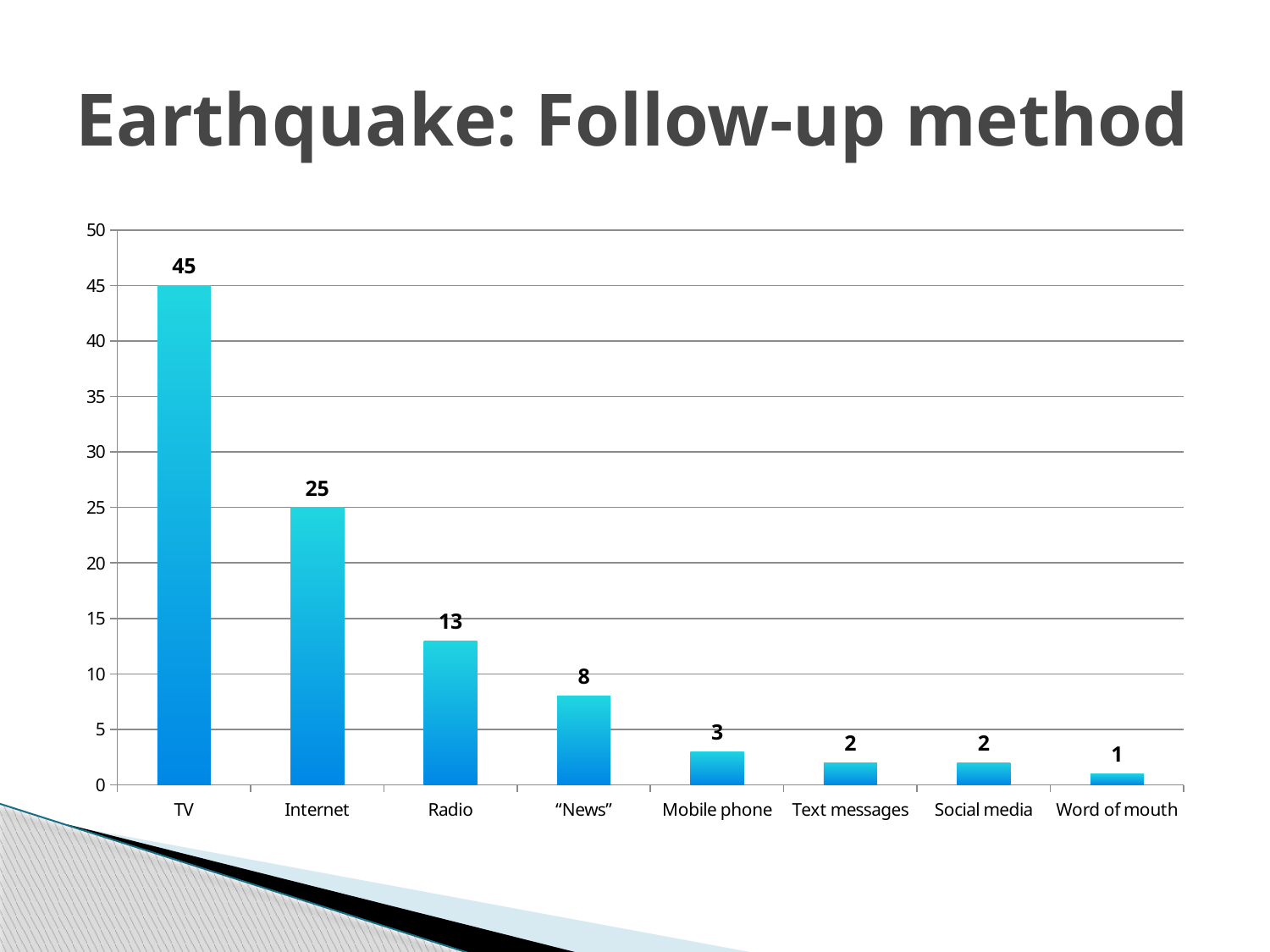
Is the value for Internet greater or less than 20? greater What is the difference between the values for TV and Internet? 20 How many categories are shown on the x axis? 8 What is the value for Radio? 13 Which is larger, the value for Internet or the value for Radio? Internet What is the title of the slide? Earthquake: Follow-up method Which category has the lowest value? Word of mouth What is the value for Mobile phone? 3 Which category has the highest value? TV What kind of chart is shown on the slide? bar chart What is the difference between the values for Radio and "News"? 5 What is the value for TV? 45